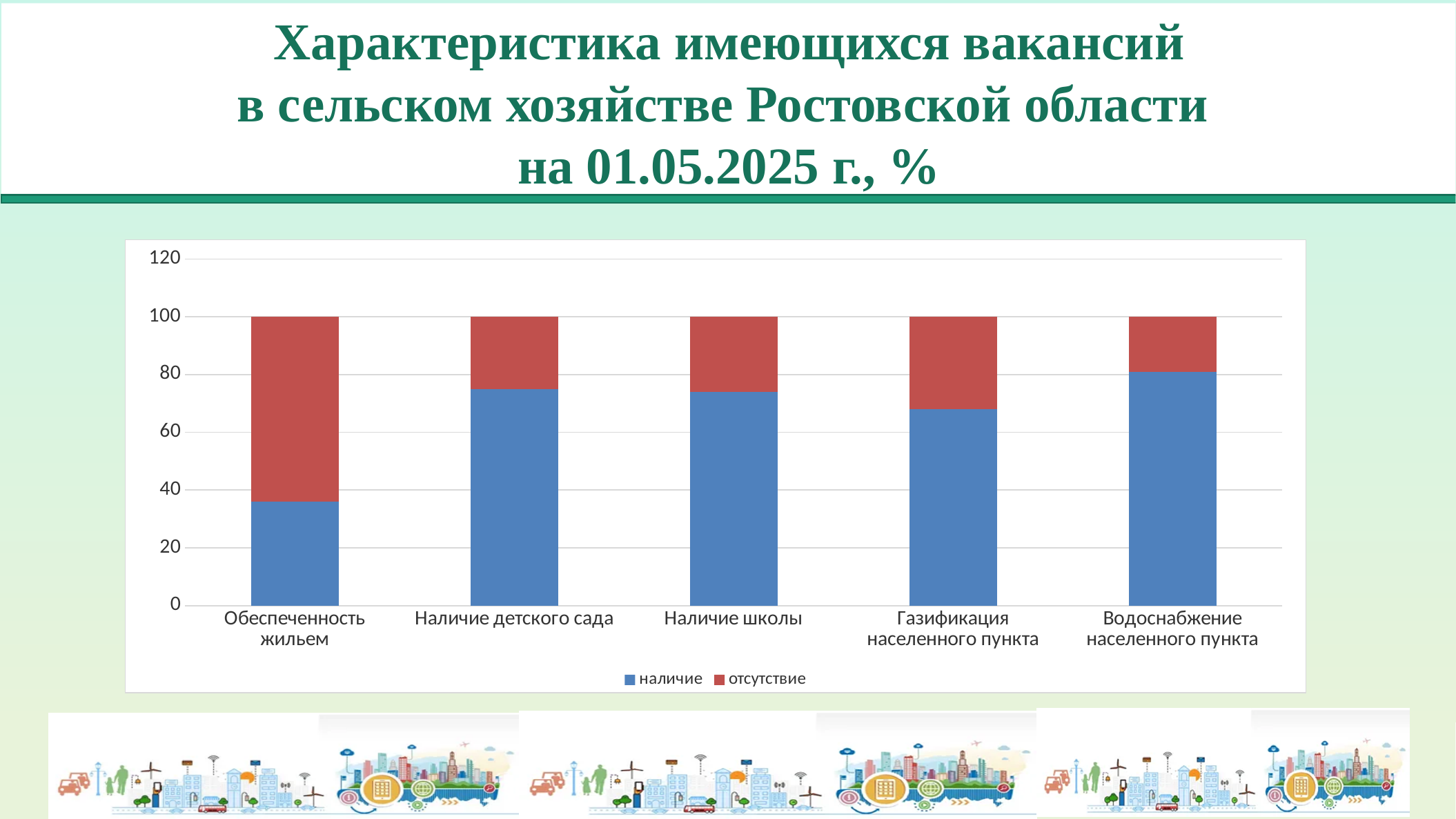
What colour represents the series 'отсутствие' in the chart? red Is the 'наличие' value for 'Наличие детского сада' greater or less than 80? less Is the 'наличие' value for 'Газификация населенного пункта' greater or less than 60? greater Is the 'наличие' value for 'Обеспеченность жильем' greater or less than 40? less Which category has the lowest value for the series 'наличие'? Обеспеченность жильем Which category has the highest value for the series 'наличие'? Водоснабжение населенного пункта How many categories are shown on the x axis of the chart? 5 How many series does the chart legend list? 2 Which category has the largest 'отсутствие' segment? Обеспеченность жильем What kind of chart is shown on the slide? stacked bar chart What is the total height of the stacked bar for 'Наличие школы'? 100 Which is larger: the 'наличие' value for 'Газификация населенного пункта' or for 'Водоснабжение населенного пункта'? Водоснабжение населенного пункта